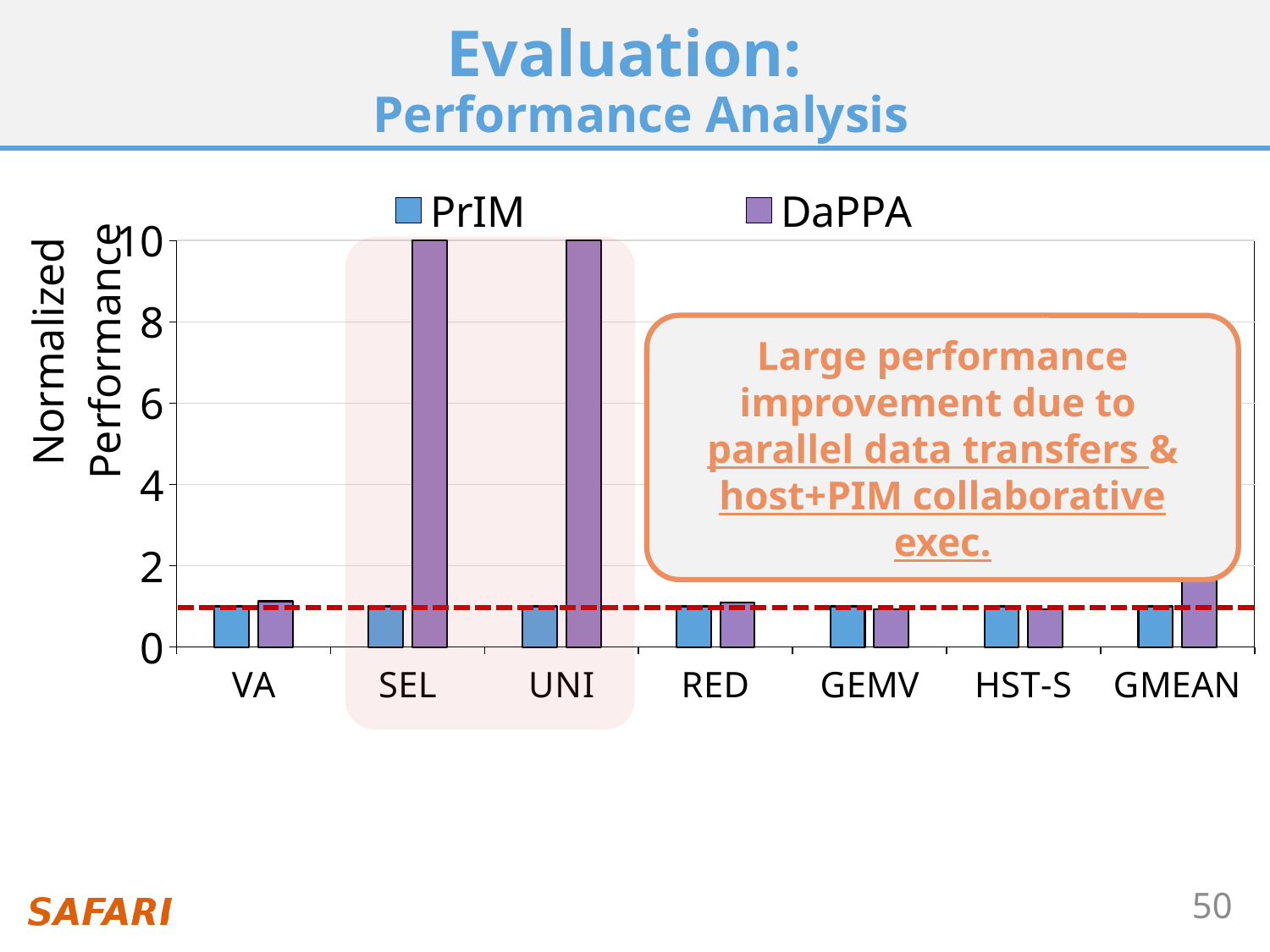
Is the DaPPA value for UNI greater or less than 6? greater Is the DaPPA value for SEL greater or less than 8? greater Which two series are listed in the legend? PrIM and DaPPA How many categories are shown along the x axis? 7 Which is larger, the DaPPA value for UNI or the PrIM value for UNI? DaPPA Which is larger, the DaPPA value for SEL or the DaPPA value for RED? SEL Is the PrIM value for GEMV greater or less than 2? less What kind of chart is shown on the slide? bar chart How many series does the legend list? 2 What is the label of the y axis? Normalized Performance